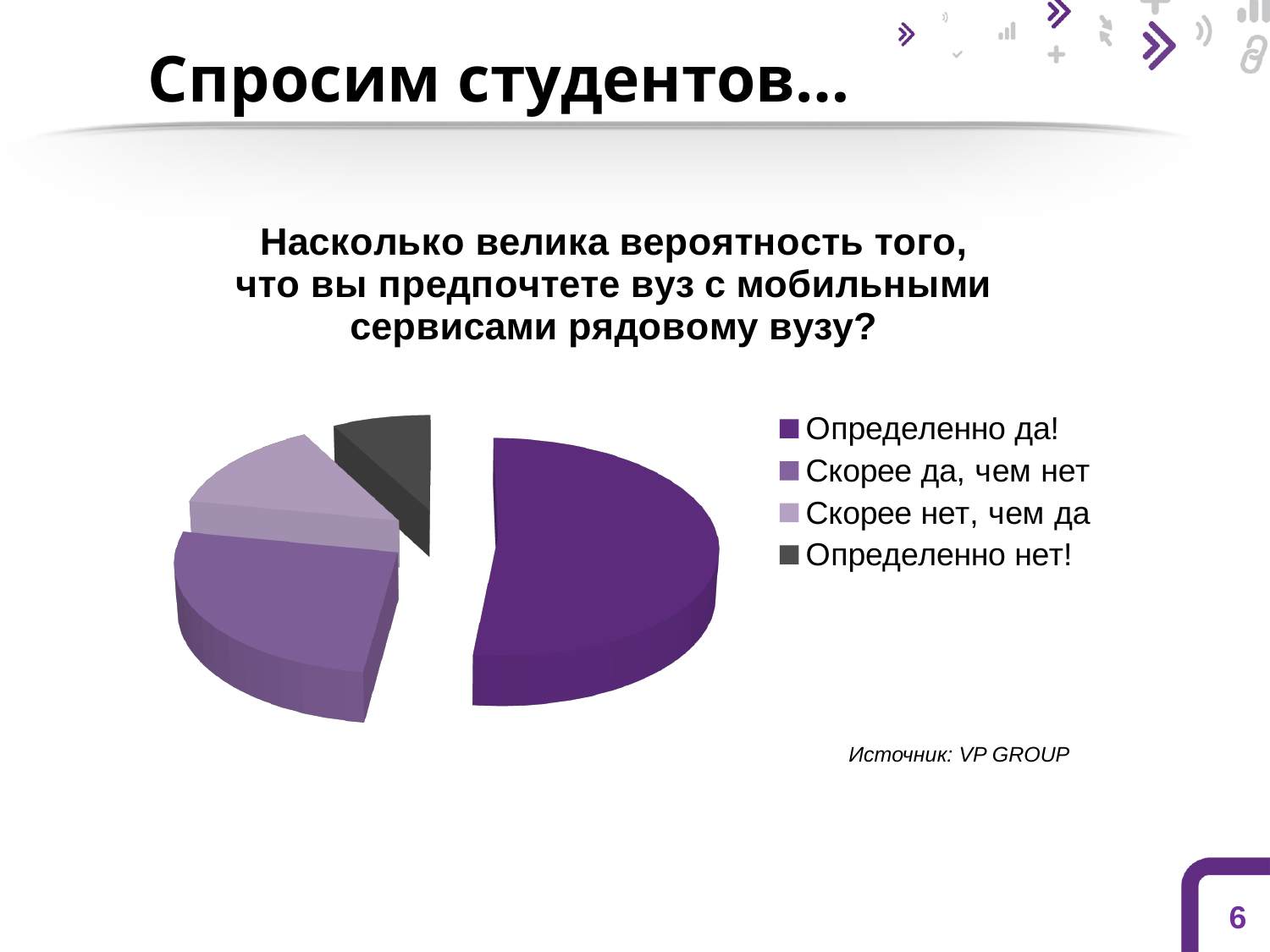
How many entries does the legend of the pie chart list? 4 Which slice is larger: "Определенно да!" or "Скорее да, чем нет"? Определенно да! What source is cited for the pie chart data? VP GROUP What kind of chart is shown on the slide? Pie chart How many slices does the pie chart have? 4 What question is the pie chart titled with? Насколько велика вероятность того, что вы предпочтете вуз с мобильными сервисами рядовому вузу? Which slice is larger: "Скорее нет, чем да" or "Определенно нет!"? Скорее нет, чем да Which answer option has the largest slice in the pie chart? Определенно да! Which slice is larger: "Скорее да, чем нет" or "Скорее нет, чем да"? Скорее да, чем нет Which answer option has the smallest slice in the pie chart? Определенно нет!